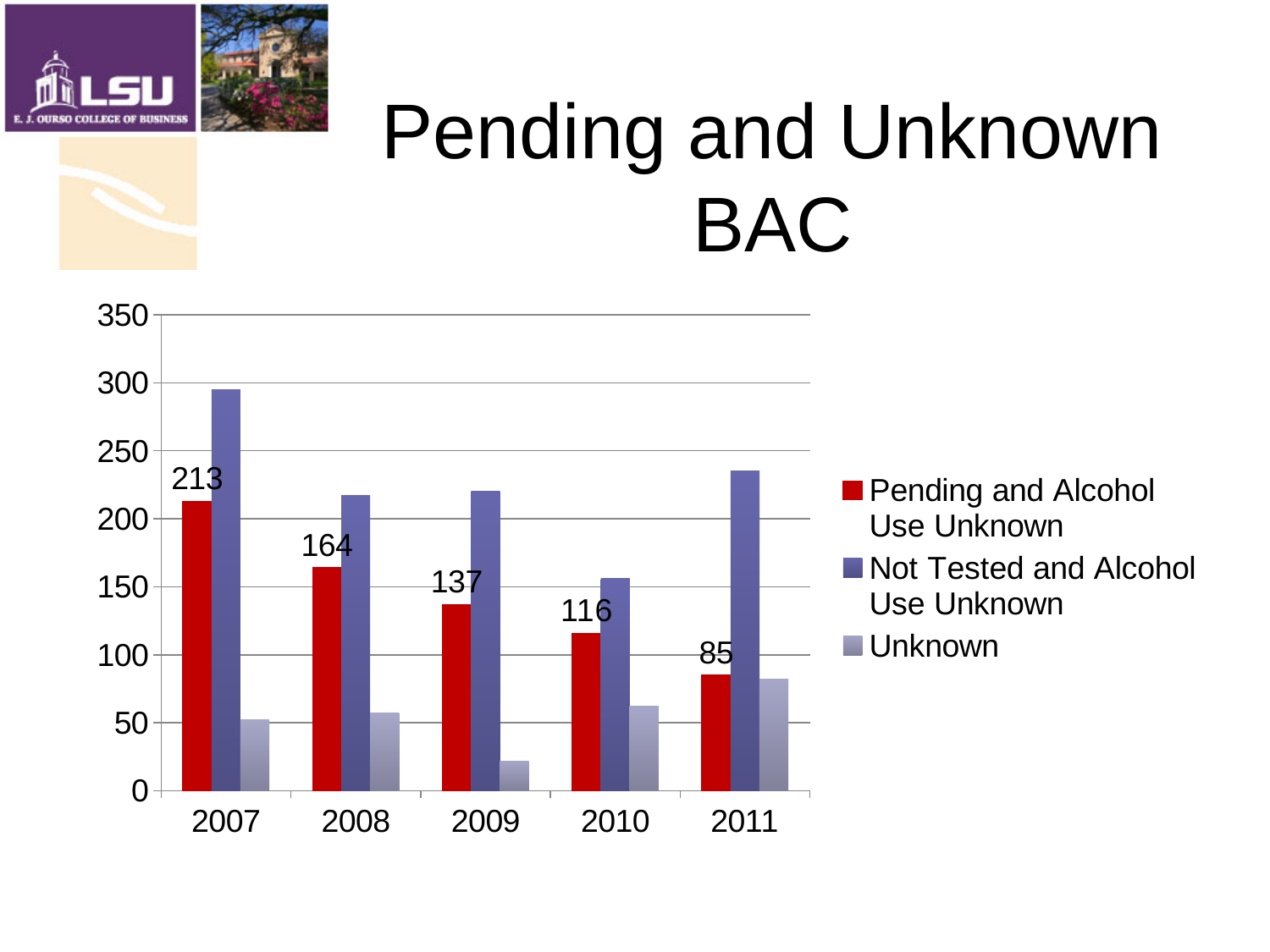
What is the difference between the Pending and Alcohol Use Unknown values for 2007 and 2008? 49 How many series does the legend list? 3 Is the value for Unknown in 2009 greater or less than 50? less What is the value for Pending and Alcohol Use Unknown in 2011? 85 Which year has the highest value for Pending and Alcohol Use Unknown? 2007 Is the value for Not Tested and Alcohol Use Unknown in 2007 greater or less than 250? greater What is the value for Pending and Alcohol Use Unknown in 2007? 213 What is the value for Pending and Alcohol Use Unknown in 2009? 137 Which is larger, the Pending and Alcohol Use Unknown value for 2009 or for 2010? 2009 How many years are shown on the x axis? 5 Do the Pending and Alcohol Use Unknown values rise or fall from 2007 to 2011? fall Which year has the lowest value for Pending and Alcohol Use Unknown? 2011